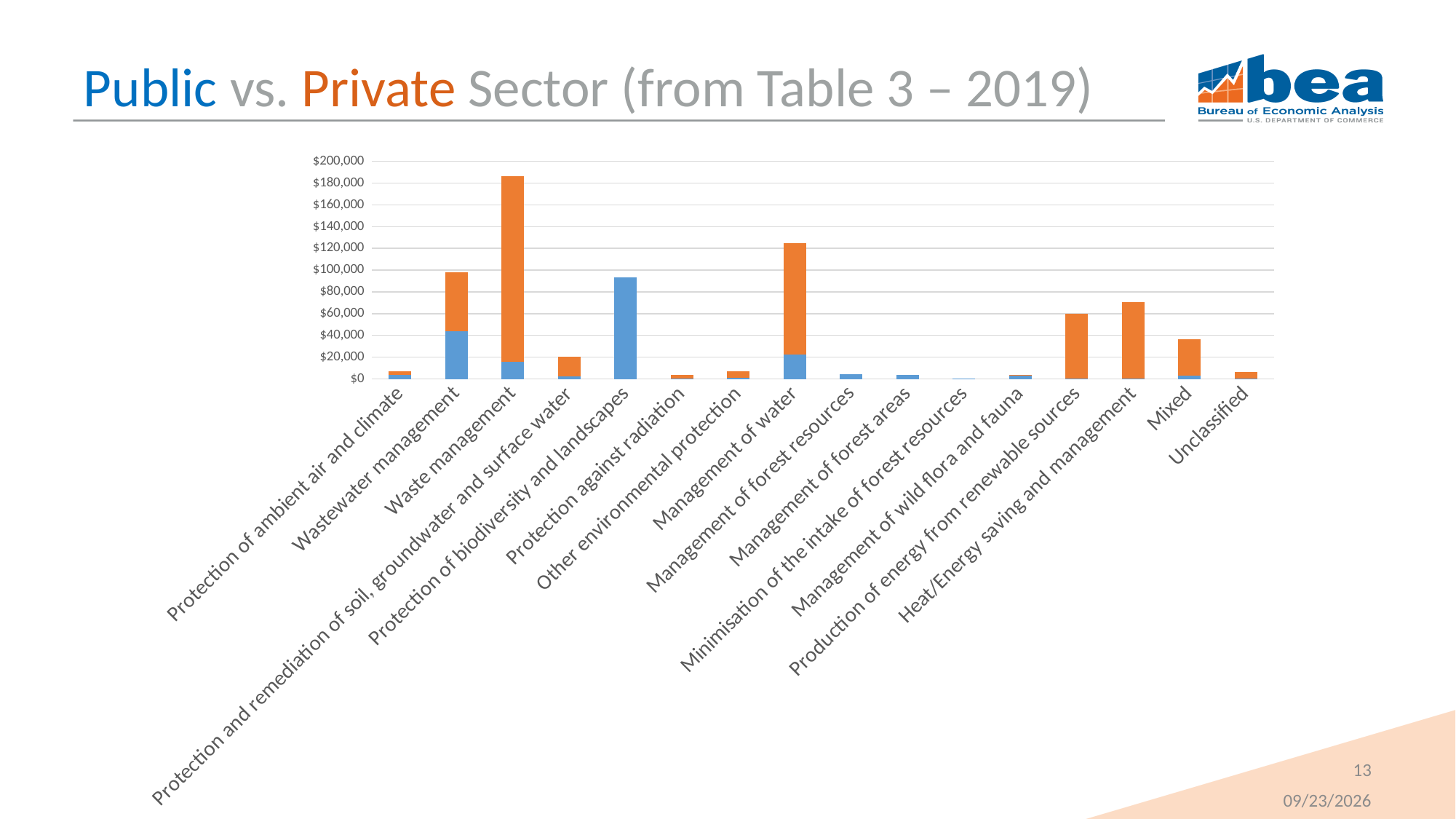
Which category has the tallest bar in the chart? Waste management Is the bar for Heat/Energy saving and management greater or less than $60,000? greater Which bar is taller: Waste management or Management of water? Waste management Is the total bar for Waste management greater or less than $180,000? greater Is the total bar for Wastewater management greater or less than $80,000? greater Which category has the largest blue (public sector) segment? Protection of biodiversity and landscapes How many categories are shown along the x axis of the chart? 16 What kind of chart is shown on the slide? Stacked bar chart What is the title of the slide containing the chart? Public vs. Private Sector (from Table 3 – 2019) Which bar is taller: Protection of biodiversity and landscapes or Mixed? Protection of biodiversity and landscapes